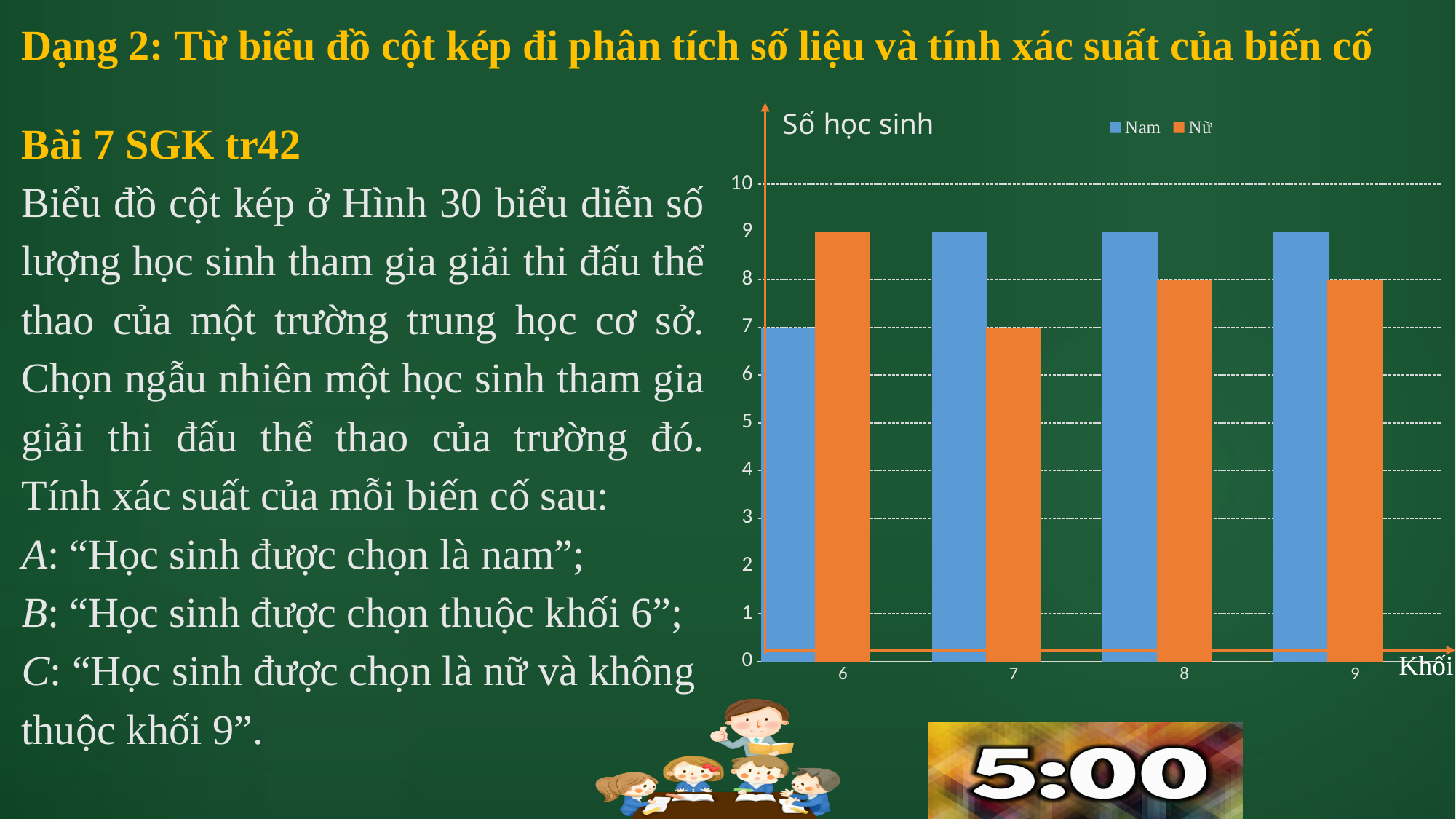
What is the value for Nam in khối 8? 9 How many khối categories are shown on the x axis? 4 What is the value for Nữ in khối 7? 7 In which khối is the Nữ value lowest? 7 In which khối is the Nam value lowest? 6 How many series does the legend list? 2 What kind of chart is shown on the slide? Bar chart What is the difference between the Nữ and Nam values in khối 6? 2 What is the value for Nữ in khối 6? 9 What is the value for Nữ in khối 9? 8 What is the value for Nam in khối 6? 7 Which is larger in khối 8, Nam or Nữ? Nam